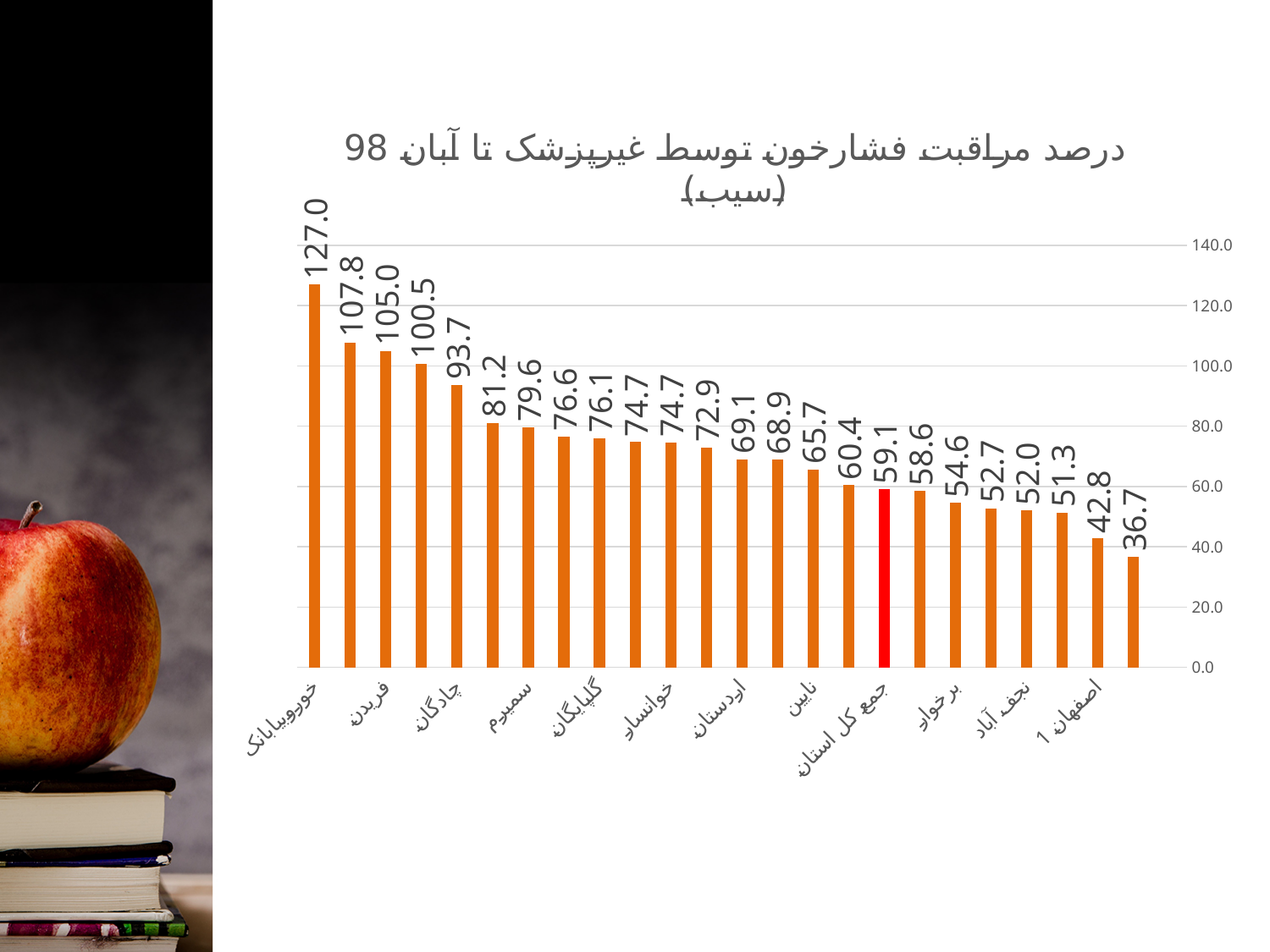
What is the lowest value shown on the chart? 36.7 What is the difference between the values for خوروبیابانک and فریدن? 22.0 Which category is shown with a red bar instead of orange? جمع کل استان What type of chart is shown on the slide? bar chart What is the value for اصفهان 1? 42.8 What is the value for جمع کل استان? 59.1 Do the values rise or fall from left to right along the x axis? fall What is the value for چادگان? 93.7 Which category has the highest value? خوروبیابانک How many bars are plotted on the chart? 24 Which has a larger value, سمیرم or نایین? سمیرم What is the value for خوروبیابانک? 127.0